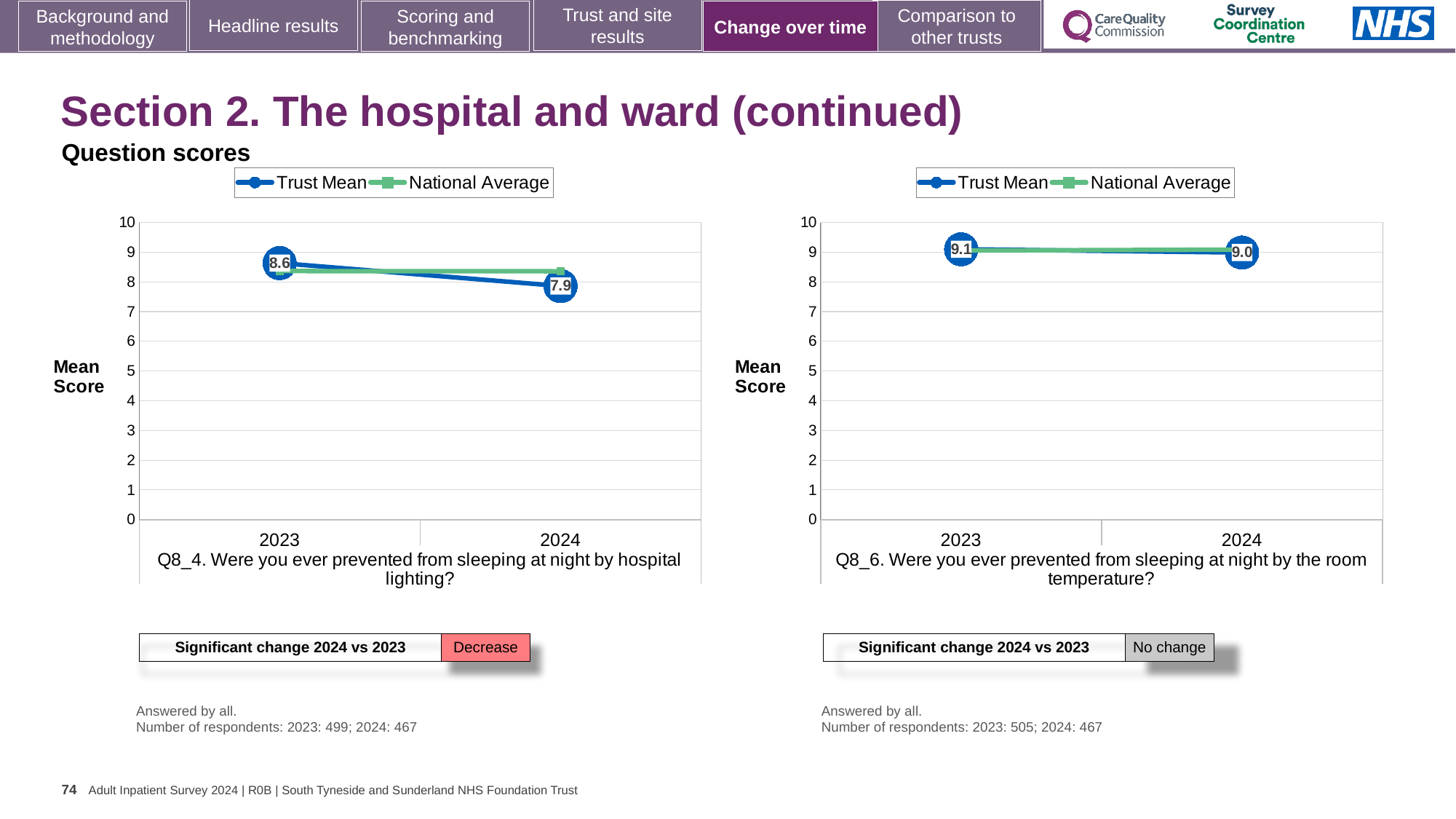
In the right chart (Q8_6, room temperature), what is the difference between the Trust Mean scores for 2023 and 2024? 0.1 In the left chart (Q8_4, hospital lighting), is the Trust Mean higher in 2023 or 2024? 2023 How many years are plotted on the x axis of the left chart (Q8_4, hospital lighting)? 2 In the left chart (Q8_4, hospital lighting), what is the Trust Mean score for 2024? 7.9 In the left chart (Q8_4, hospital lighting), by how much did the Trust Mean score fall from 2023 to 2024? 0.7 In the left chart (Q8_4, hospital lighting), does the Trust Mean rise or fall from 2023 to 2024? fall In the right chart (Q8_6, room temperature), what is the Trust Mean score for 2023? 9.1 In the left chart (Q8_4, hospital lighting), what is the Trust Mean score for 2023? 8.6 What kind of chart is used on this slide to show the question scores? line chart How many series does the legend of the right chart (Q8_6, room temperature) list? 2 In the right chart (Q8_6, room temperature), what is the Trust Mean score for 2024? 9.0 In the left chart (Q8_4, hospital lighting), is the National Average for 2024 greater or less than 8? greater